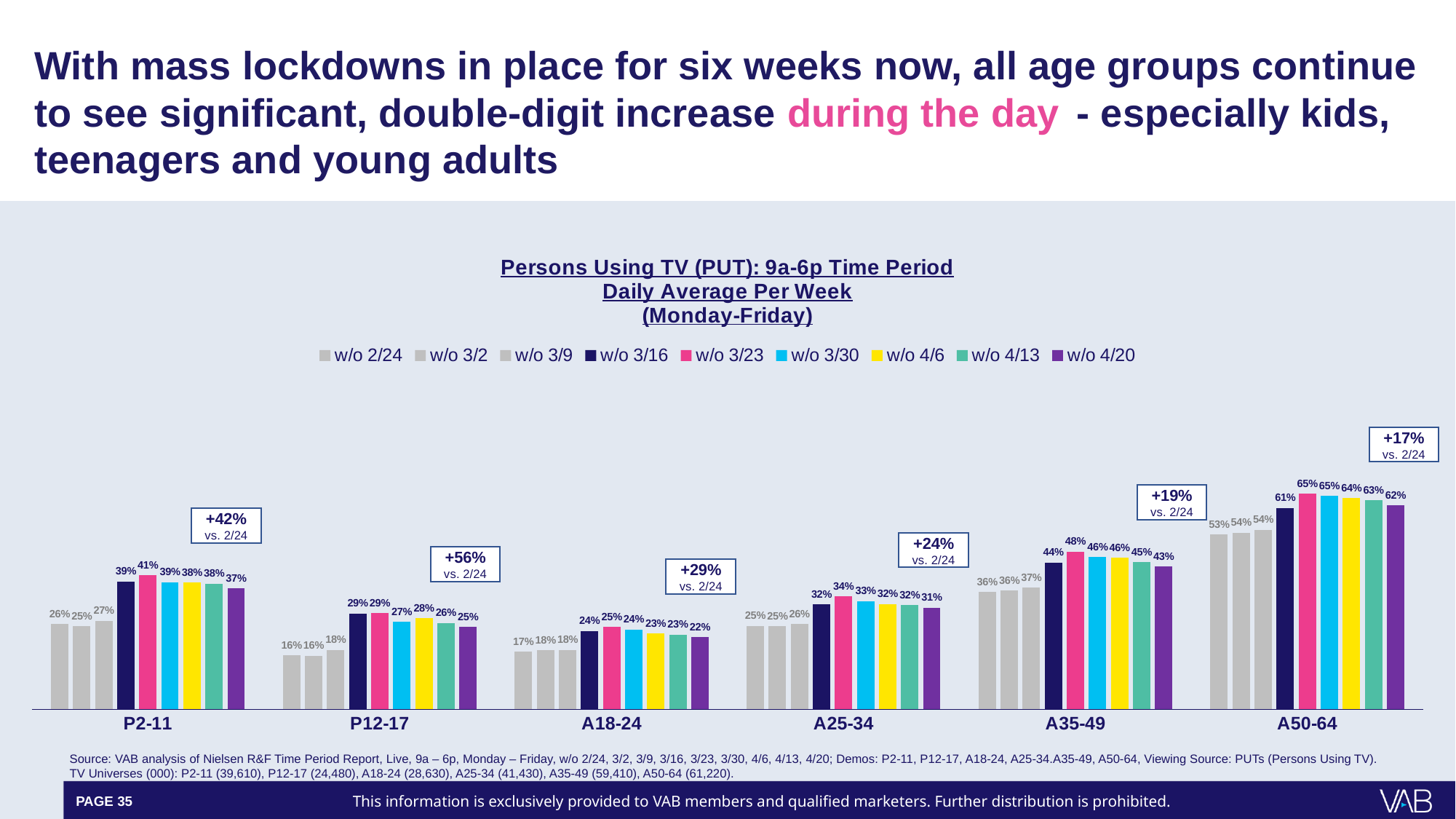
What percentage increase vs. 2/24 is annotated above the P12-17 group? +56% For A25-34, which is larger: the w/o 3/23 value or the w/o 4/20 value? w/o 3/23 How many series does the legend list? 9 What is the value for A35-49 in the w/o 4/20 series? 43% Which age group has the highest value in the w/o 3/23 series? A50-64 What is the value for P12-17 in the w/o 2/24 series? 16% What kind of chart is shown on the slide? Bar chart How many age groups are shown on the x axis? 6 Which age group has the lowest value in the w/o 2/24 series? P12-17 What is the value for A50-64 in the w/o 3/23 series? 65% What is the difference between the w/o 3/23 value and the w/o 2/24 value for P2-11? 15% What is the title of the chart? Persons Using TV (PUT): 9a-6p Time Period Daily Average Per Week (Monday-Friday)